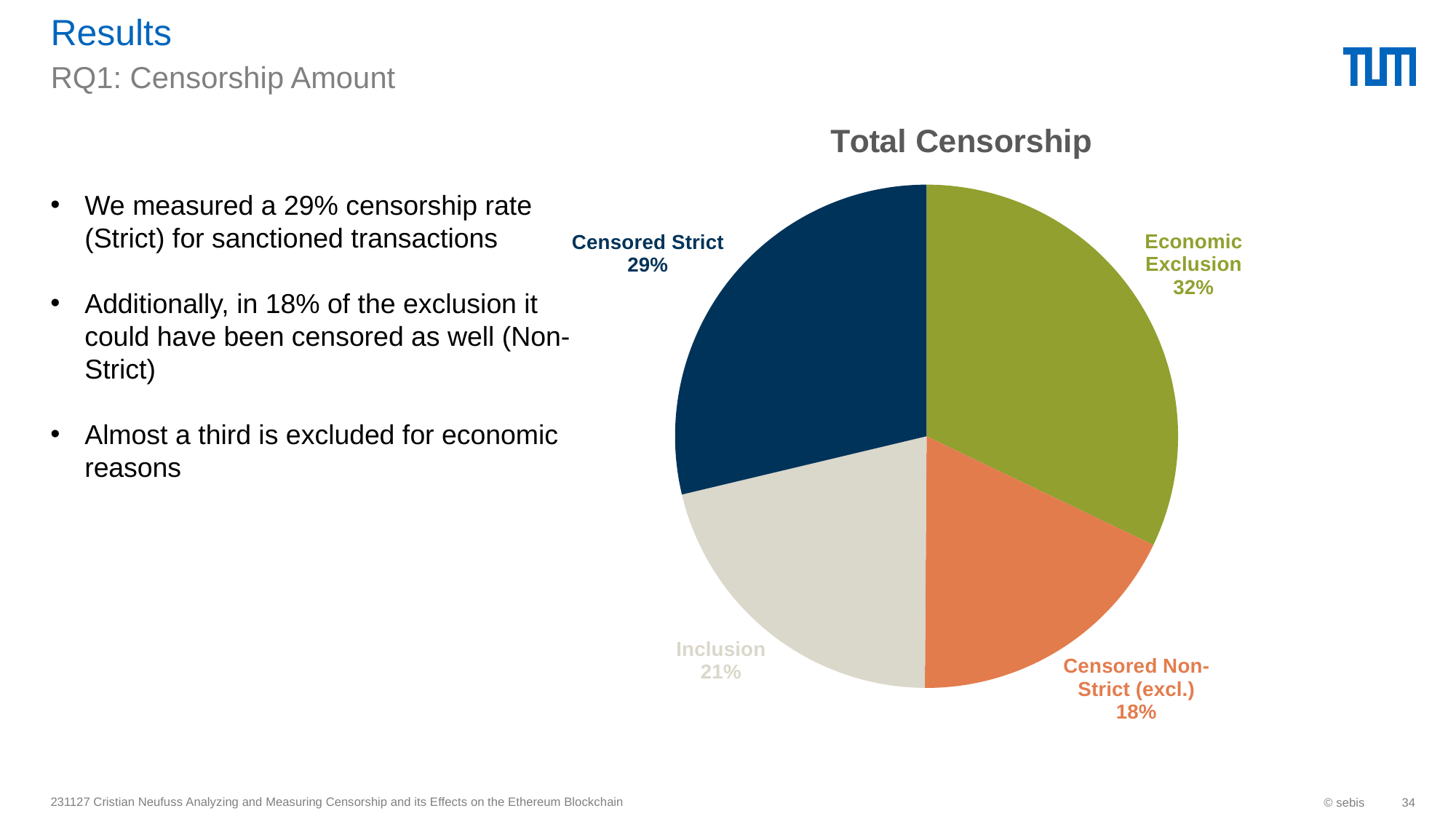
How many slices does the pie chart have? 4 What colour is the Censored Strict slice? dark blue What type of chart is shown on the slide? pie chart Which slice of the pie is the largest? Economic Exclusion What share of the pie is Censored Strict? 29% What is the difference in percentage points between Economic Exclusion and Censored Non-Strict (excl.)? 14 percentage points Which slice of the pie is the smallest? Censored Non-Strict (excl.) What is the title of the chart? Total Censorship What share of the pie is Inclusion? 21% What share of the pie is Economic Exclusion? 32% Which is larger, Censored Strict or Inclusion? Censored Strict